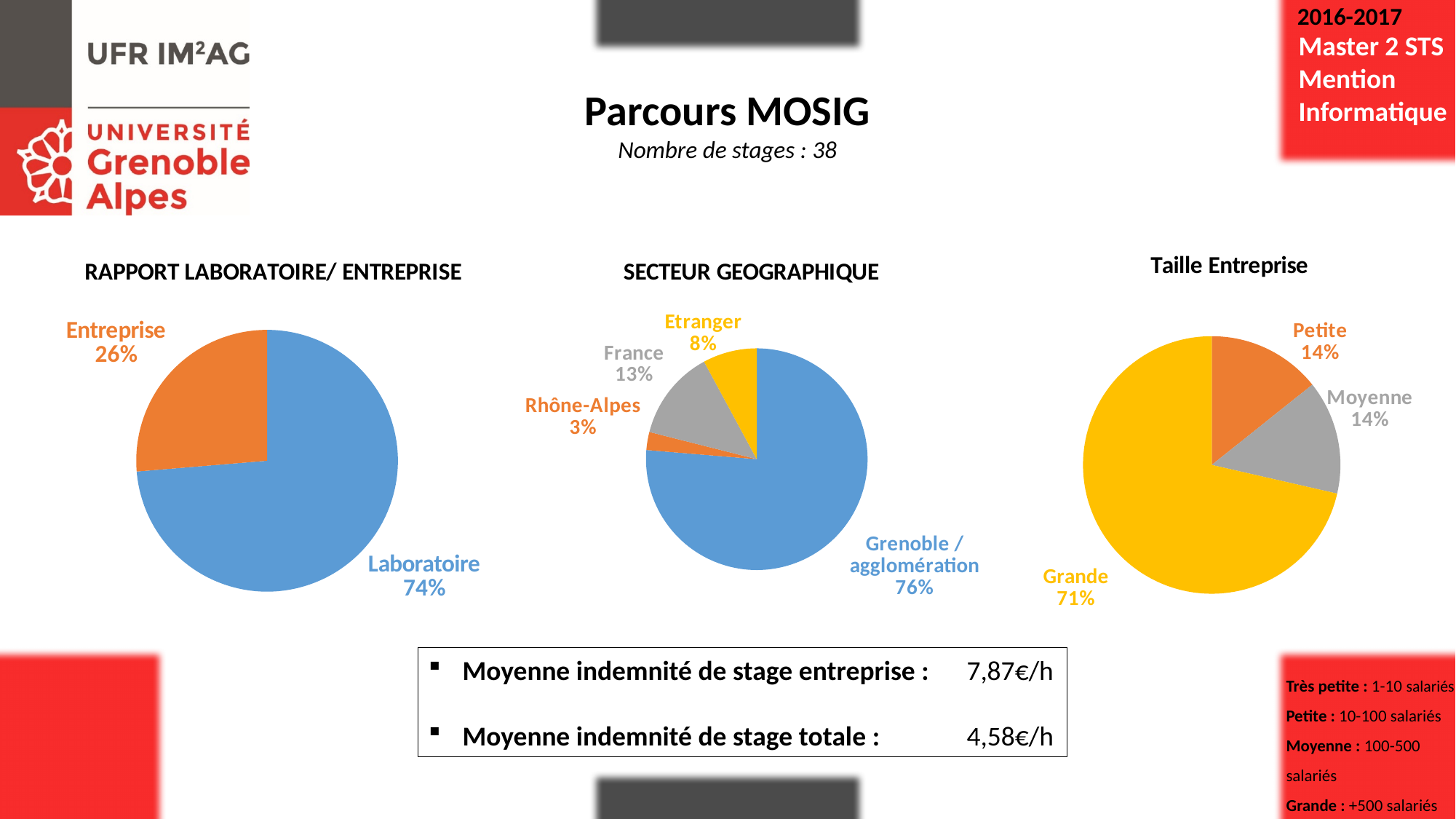
In the SECTEUR GEOGRAPHIQUE chart, what share is Grenoble / agglomération? 76% In the SECTEUR GEOGRAPHIQUE chart, which is larger, France or Etranger? France What is the title of the middle chart on the slide? SECTEUR GEOGRAPHIQUE In the Taille Entreprise chart, what is the difference between the Grande and Petite shares? 57% In the RAPPORT LABORATOIRE/ ENTREPRISE chart, what share of internships is in Entreprise? 26% In the SECTEUR GEOGRAPHIQUE chart, which category has the smallest share? Rhône-Alpes In the RAPPORT LABORATOIRE/ ENTREPRISE chart, what share of internships is in Laboratoire? 74% In the RAPPORT LABORATOIRE/ ENTREPRISE chart, what is the difference between the Laboratoire and Entreprise shares? 48% What kind of chart is the Taille Entreprise chart? Pie chart In the SECTEUR GEOGRAPHIQUE chart, how many categories are shown? 4 In the Taille Entreprise chart, how many categories are shown? 3